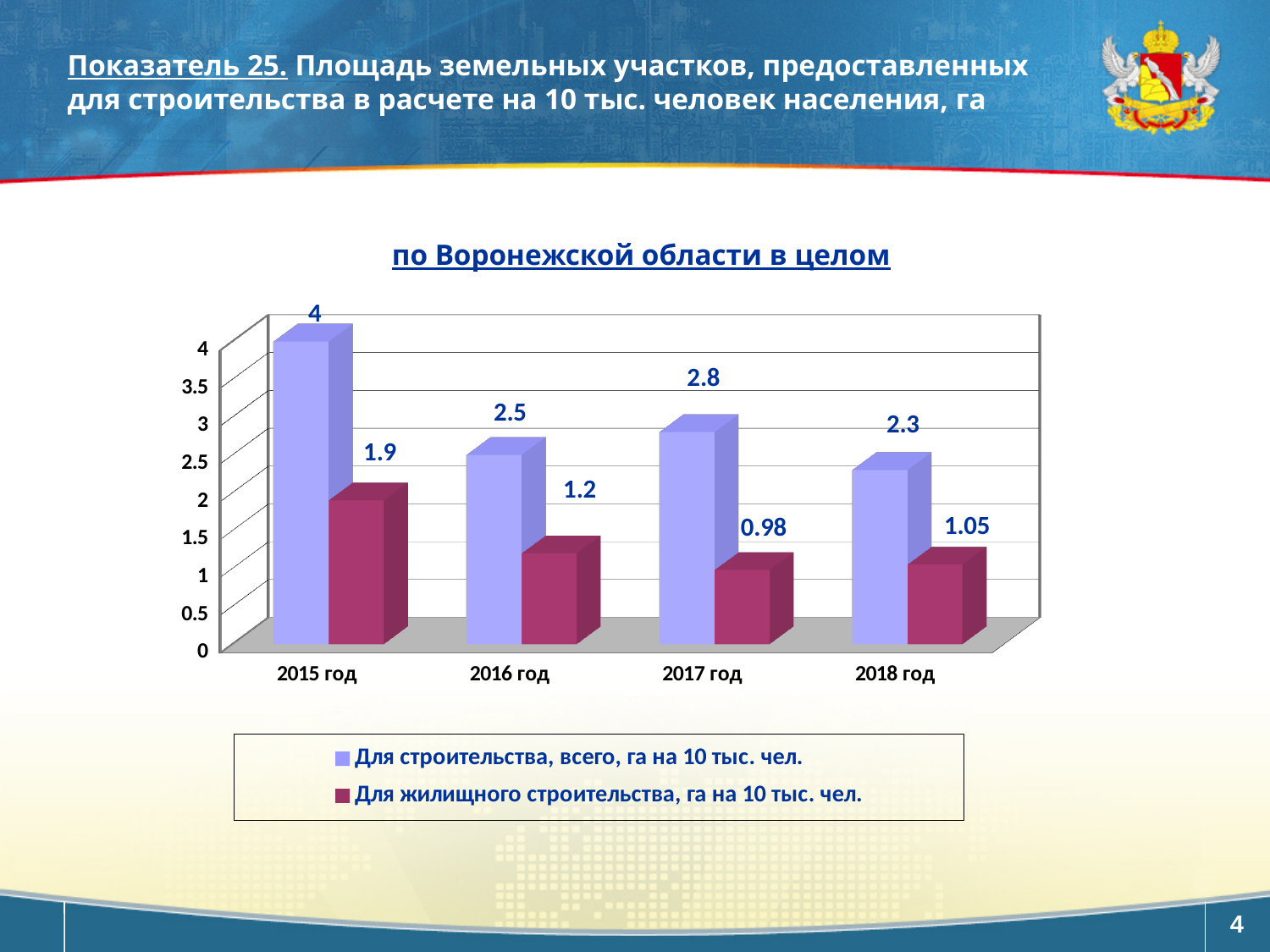
What is the difference between the two series in 2016 год? 1.3 What kind of chart is shown on the slide? bar chart Which year has the highest value for 'Для строительства, всего, га на 10 тыс. чел.'? 2015 год Which year has the lowest value for 'Для жилищного строительства, га на 10 тыс. чел.'? 2017 год What is the value for 'Для жилищного строительства, га на 10 тыс. чел.' in 2018 год? 1.05 What is the value for 'Для жилищного строительства, га на 10 тыс. чел.' in 2017 год? 0.98 Is the value for 'Для строительства, всего' in 2018 год greater or less than 2? greater What is the title shown above the chart? по Воронежской области в целом What is the value for 'Для строительства, всего, га на 10 тыс. чел.' in 2015 год? 4 How many years are shown on the x axis? 4 Which is larger: 'Для строительства, всего' in 2017 год or in 2018 год? 2017 год How many series does the legend list? 2